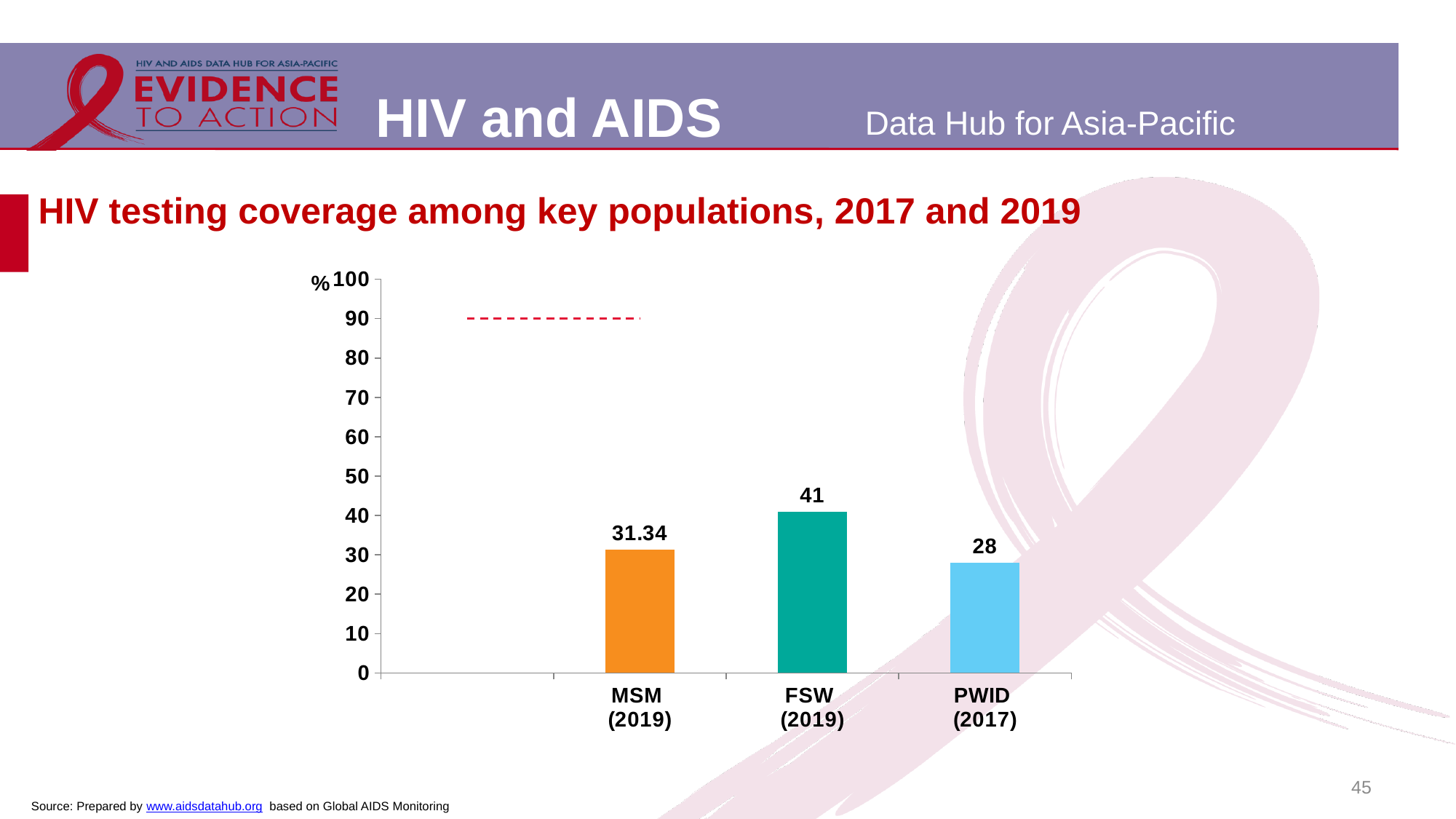
What kind of chart is shown on the slide? bar chart What is the difference between the HIV testing coverage for FSW (2019) and MSM (2019)? 9.66 Which key population has the highest HIV testing coverage? FSW (2019) Which key population has the lowest HIV testing coverage? PWID (2017) Is the value for FSW (2019) greater or less than 50? less What is the difference between the HIV testing coverage for FSW (2019) and PWID (2017)? 13 What is the HIV testing coverage value for FSW (2019)? 41 Which has a higher HIV testing coverage, MSM (2019) or PWID (2017)? MSM (2019) How many key populations are shown in the chart? 3 At what level on the y axis is the red dashed line drawn? 90 What is the HIV testing coverage value for MSM (2019)? 31.34 What is the HIV testing coverage value for PWID (2017)? 28